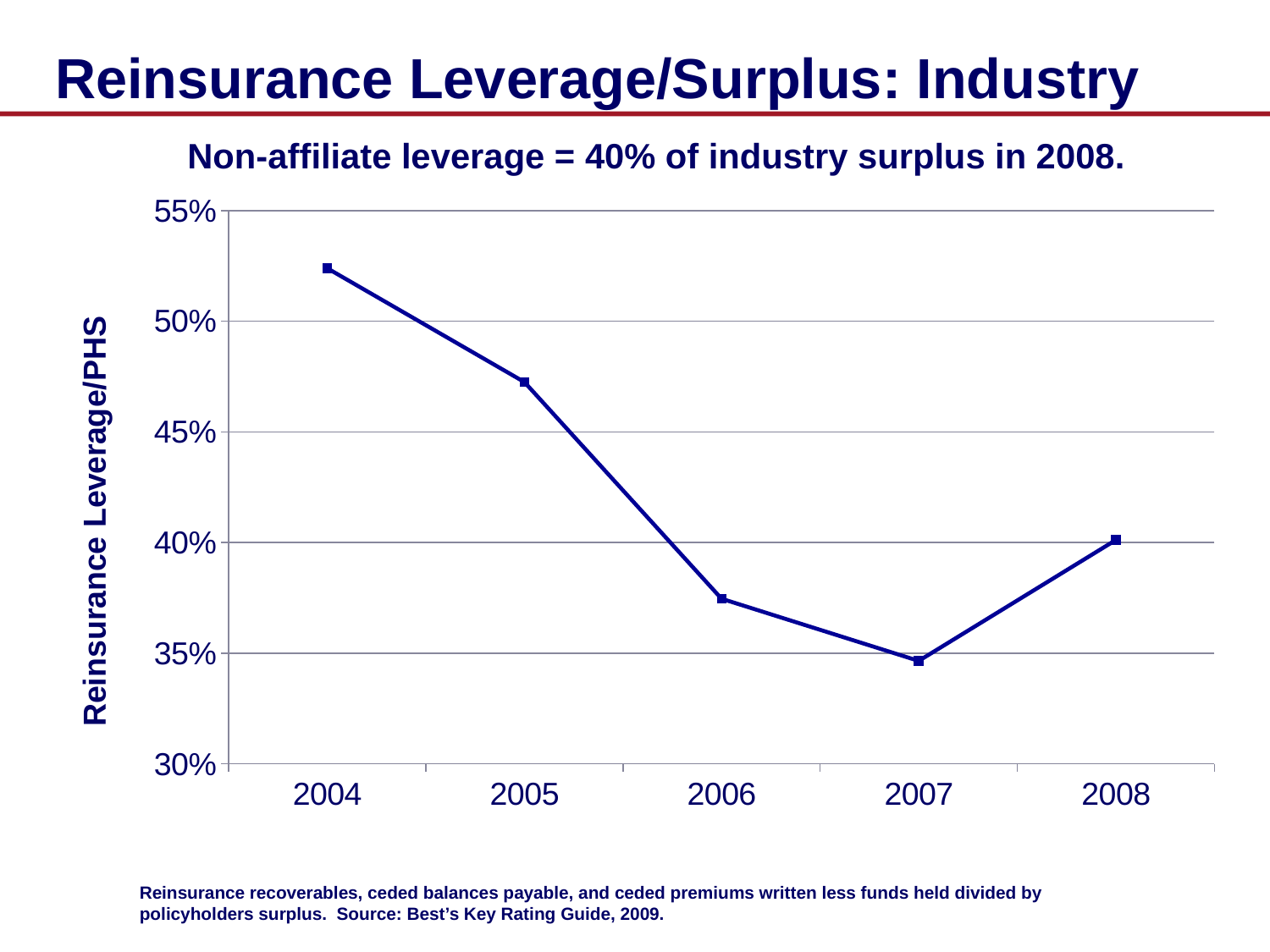
What is the label on the vertical axis? Reinsurance Leverage/PHS Is the value for 2006 greater or less than 40%? less How does reinsurance leverage/PHS change from 2004 to 2007? It falls Which year has the larger value, 2005 or 2006? 2005 Is the value for 2004 greater or less than 50%? greater Which year has the lowest reinsurance leverage/PHS? 2007 What kind of chart is shown on the slide? line chart What was non-affiliate leverage as a share of industry surplus in 2008? 40% How many years are plotted on the x axis? 5 Which year has the highest reinsurance leverage/PHS? 2004 Is the value for 2005 greater or less than 50%? less